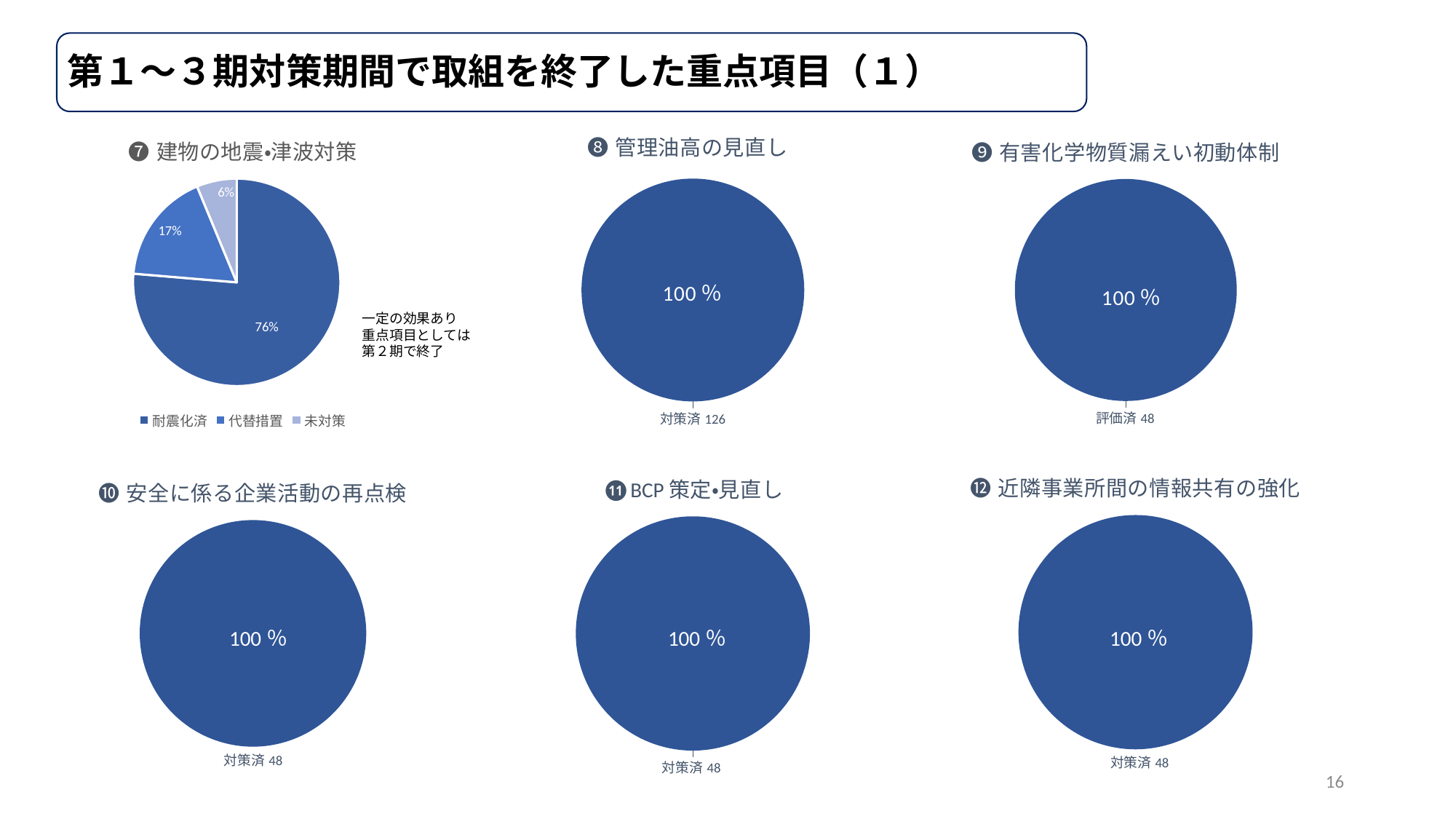
In the chart titled 建物の地震•津波対策, what share of the pie is 未対策? 6% In the chart titled 建物の地震•津波対策, how many categories does the legend list? 3 In the chart titled 建物の地震•津波対策, which category has the largest slice? 耐震化済 In the chart titled 有害化学物質漏えい初動体制, what value is shown for 評価済? 48 In the chart titled 建物の地震•津波対策, what share of the pie is 耐震化済? 76% In the chart titled 建物の地震•津波対策, which category has the smallest slice? 未対策 What kind of chart is used for 管理油高の見直し? Pie chart In the chart titled 建物の地震•津波対策, what share of the pie is 代替措置? 17% In the chart titled 管理油高の見直し, what value is shown for 対策済? 126 How many pie charts are shown on the slide? 6 In the chart titled 建物の地震•津波対策, what is the difference in percentage points between 耐震化済 and 代替措置? 59